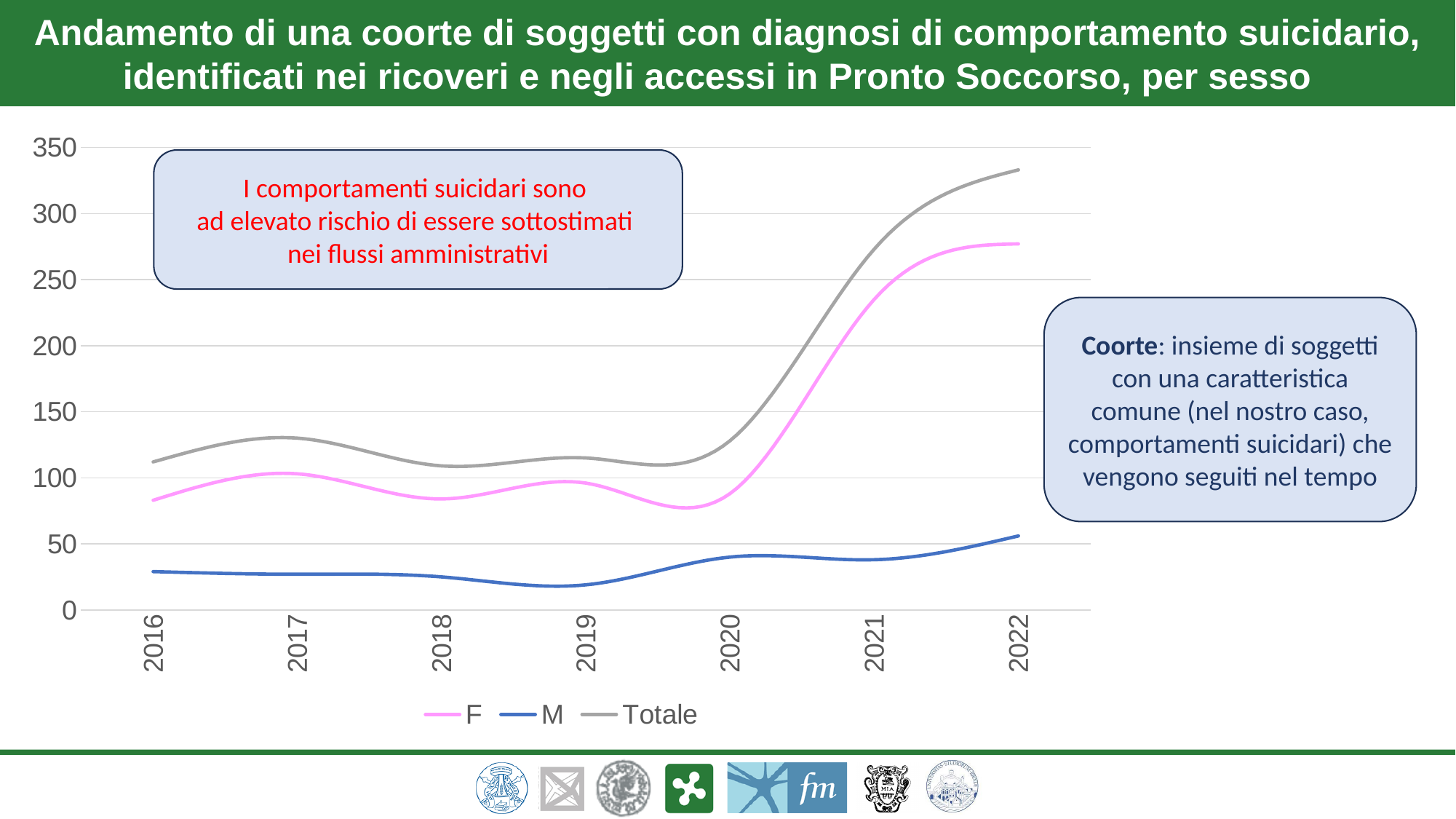
Is the value for F in 2016 greater or less than 100? less How many years are shown on the x axis? 7 Which series does the grey line represent? Totale Is the value for Totale in 2022 greater or less than 300? greater In which year does the Totale series reach its highest value? 2022 Is the value for F in 2022 greater or less than 250? greater What kind of chart is shown on the slide? line chart Which series has the larger value in 2022, F or M? F Does the Totale series rise or fall between 2020 and 2022? rise How many series does the legend list? 3 In which year does the M series reach its lowest value? 2019